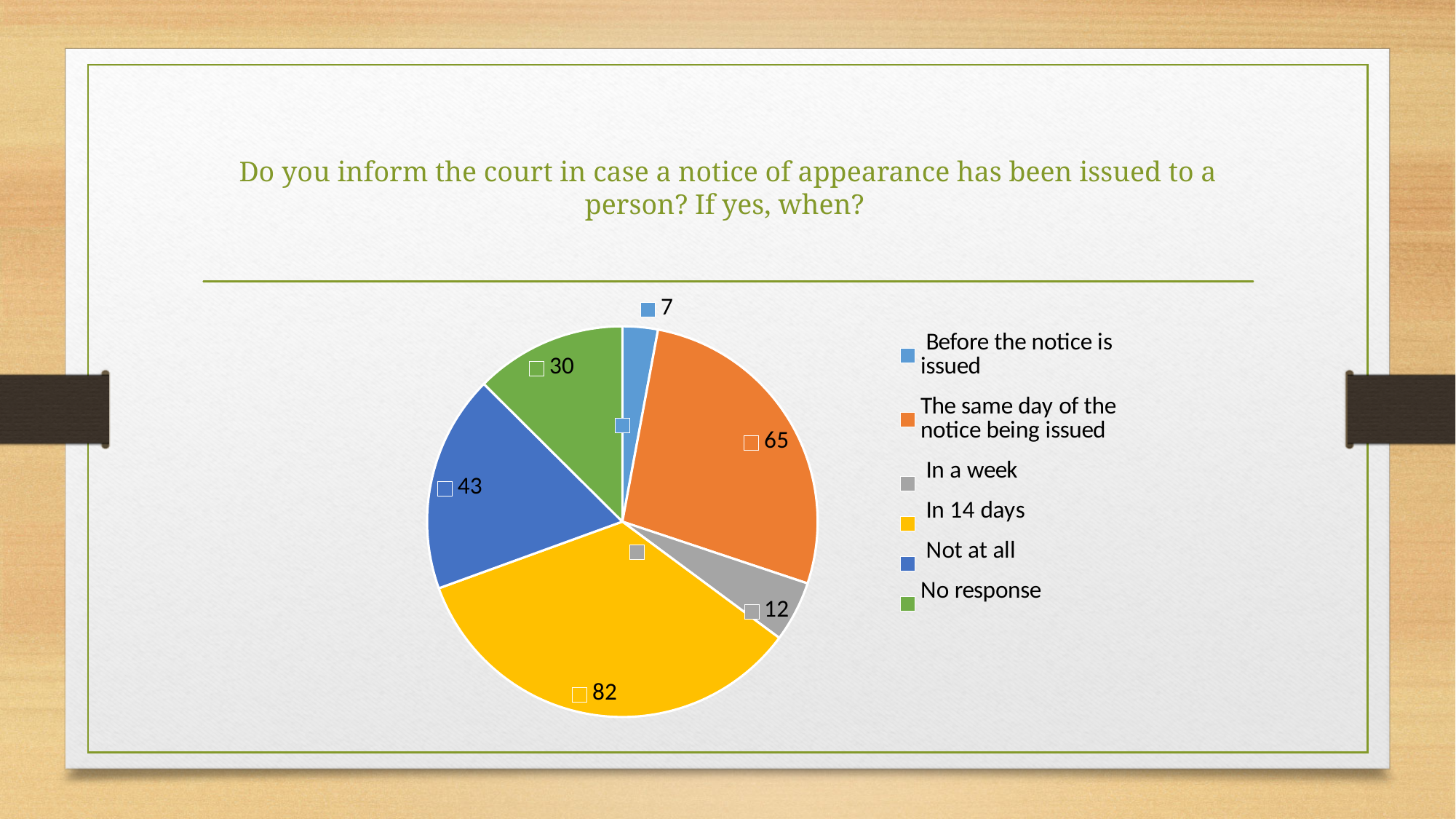
What colour is the slice for "In a week"? grey What is the value for "Before the notice is issued"? 7 How many categories does the pie chart have? 6 What is the difference between the values for "In 14 days" and "The same day of the notice being issued"? 17 Which category has the smallest slice? Before the notice is issued What is the total of all the slice values in the pie chart? 239 What type of chart is shown on the slide? pie chart What is the value for "The same day of the notice being issued"? 65 What is the value for "In 14 days"? 82 Which is larger, the value for "Not at all" or the value for "No response"? Not at all What is the value for "Not at all"? 43 Which category has the largest slice? In 14 days